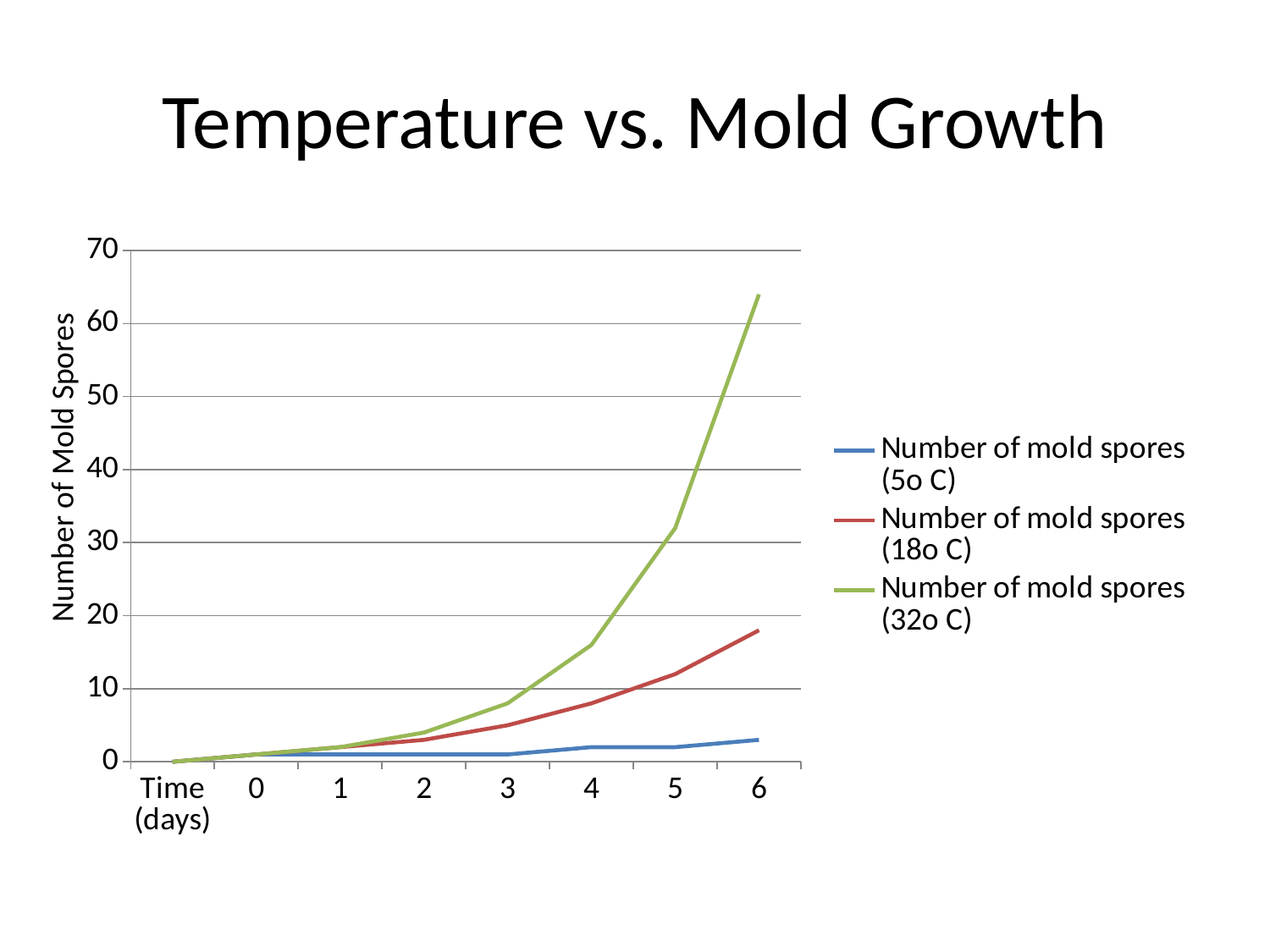
Which series has the lowest value at day 6? Number of mold spores (5o C) Is the value for Number of mold spores (18o C) at day 6 greater or less than 10? greater How many series does the legend list? 3 Is the value for Number of mold spores (32o C) at day 6 greater or less than 60? greater What kind of chart is shown on the slide? line chart Is the value for Number of mold spores (5o C) at day 6 greater or less than 10? less Which series has the highest value at day 6? Number of mold spores (32o C) Does the Number of mold spores (32o C) series rise or fall as the days increase? rise What is the title of the chart? Temperature vs. Mold Growth What is the label on the vertical axis? Number of Mold Spores At day 6, which is larger: Number of mold spores (32o C) or Number of mold spores (18o C)? Number of mold spores (32o C)